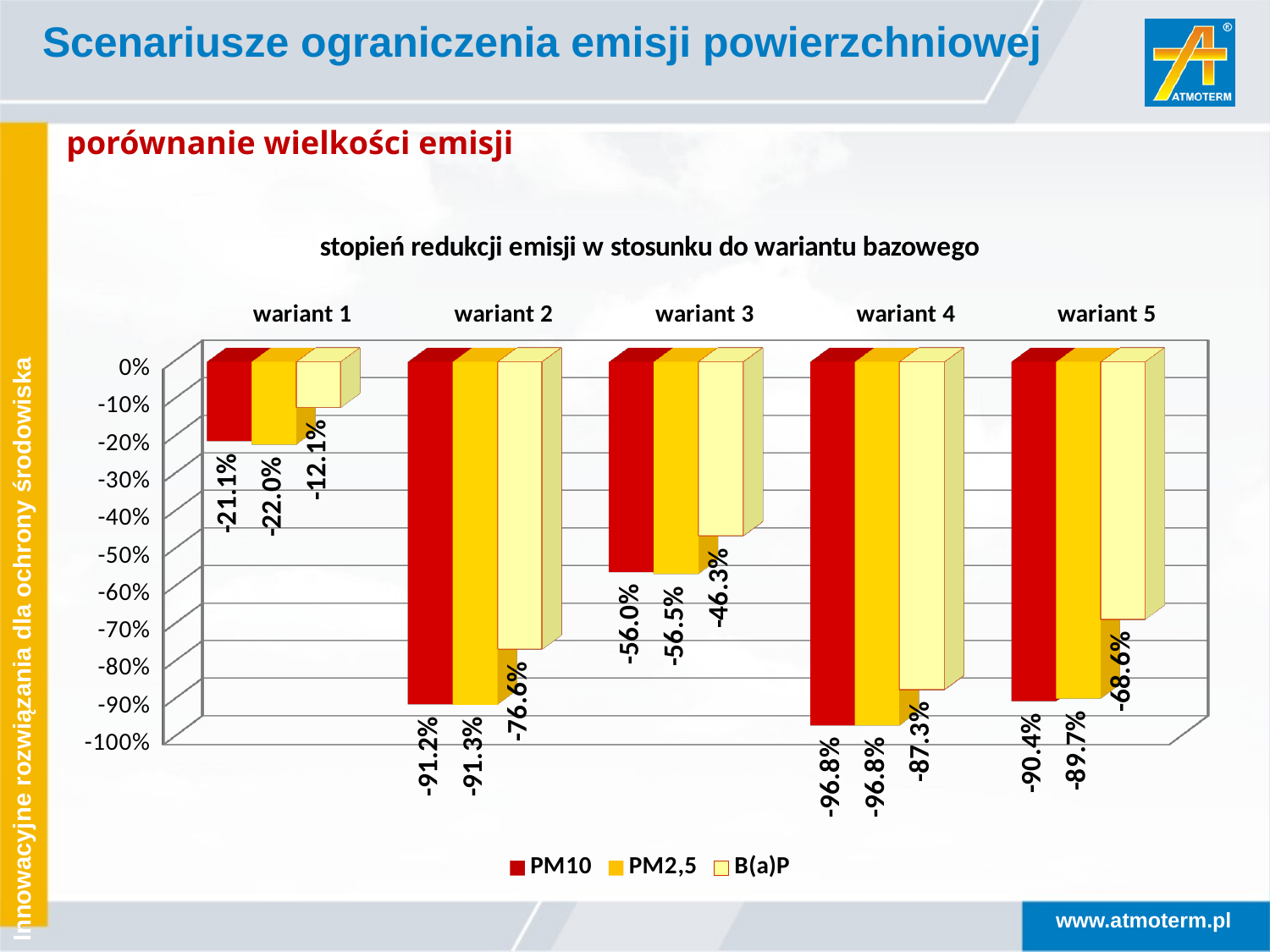
What is the value for PM10 in wariant 3? -56.0% How many wariant categories are shown on the x axis? 5 Which wariant shows the smallest reduction (value closest to 0%) for B(a)P? wariant 1 What is the title of the chart? stopień redukcji emisji w stosunku do wariantu bazowego Which has a larger reduction for PM2,5: wariant 3 or wariant 5? wariant 5 What is the value for B(a)P in wariant 1? -12.1% What is the value for PM2,5 in wariant 5? -89.7% How many series does the legend list? 3 Which wariant shows the largest reduction (most negative value) for PM10? wariant 4 What kind of chart is shown on the slide? bar chart What is the difference in percentage points between the B(a)P values for wariant 2 and wariant 1? 64.5 percentage points What is the value for B(a)P in wariant 2? -76.6%